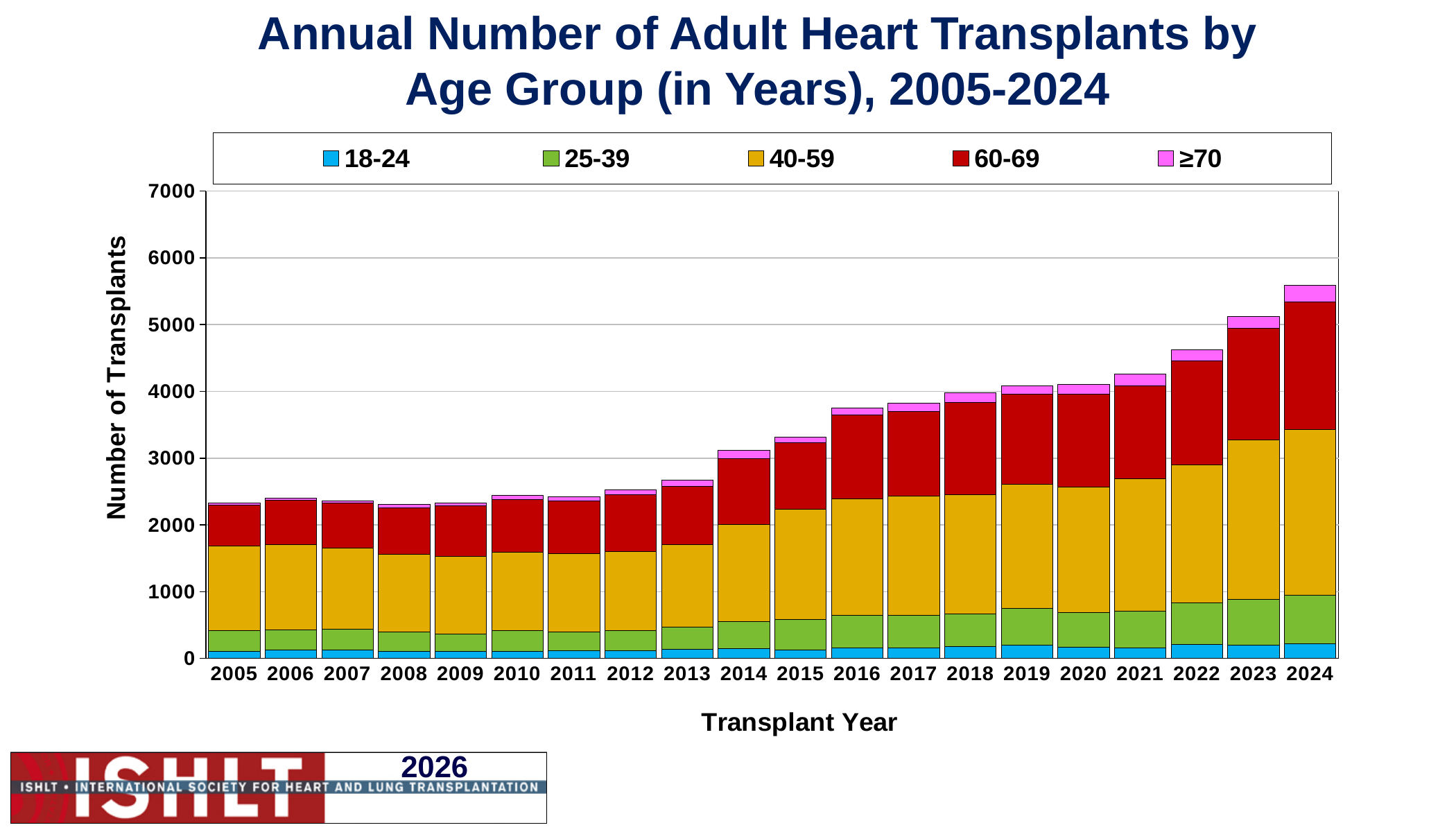
Which age group contributes the largest segment to the 2024 bar? 40-59 Is the total number of transplants in 2022 greater or less than 5000? less How many age groups does the legend list? 5 What colour represents the 60-69 age group in the legend? red Is the total number of transplants in 2005 greater or less than 3000? less What kind of chart is shown on the slide? stacked bar chart Which year has the highest total number of transplants? 2024 Is the total number of transplants in 2024 greater or less than 5000? greater Does the total number of transplants generally rise or fall from 2005 to 2024? rise Which year has a larger total number of transplants, 2010 or 2016? 2016 How many transplant years are shown on the x axis? 20